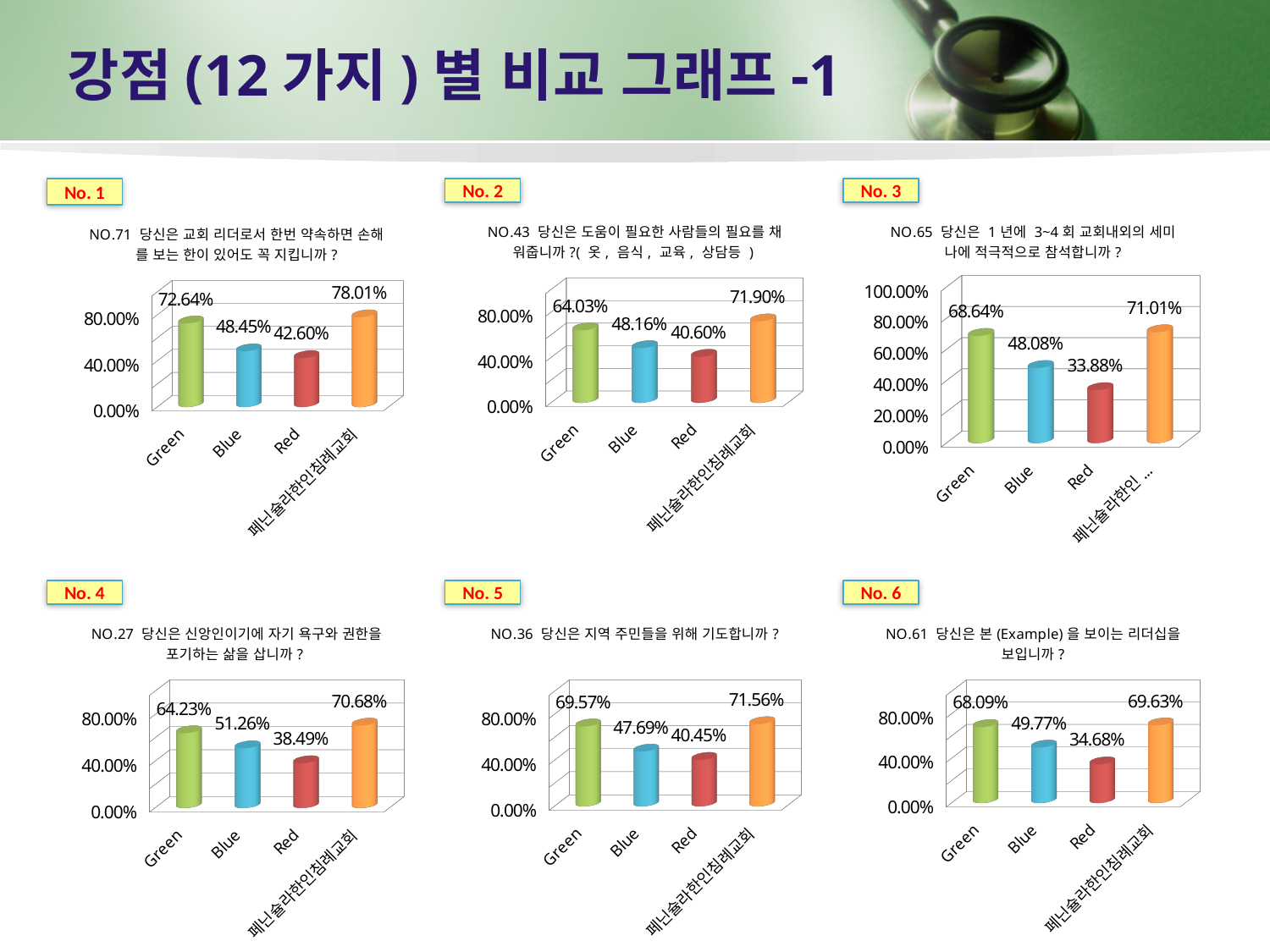
In the No. 3 chart, what is the value for 페닌술라한인침례교회? 71.01% In the No. 2 chart, which category has the highest value? 페닌슐라한인침례교회 In the No. 4 chart, what is the value for Blue? 51.26% In the No. 6 chart, is the value for Red greater or less than 40.00%? less In the No. 3 chart, which category has the lowest value? Red What kind of chart is the No. 6 chart? bar chart In the No. 5 chart, which is larger, the value for Green or the value for Blue? Green In the No. 1 chart, what is the value for Green? 72.64% In the No. 4 chart, what is the difference between the values for Blue and Red? 12.77% How many categories are shown on the x axis of the No. 5 chart? 4 In the No. 2 chart, what is the value for Red? 40.60% In the No. 1 chart, what is the difference between the values for 페닌술라한인침례교회 and Green? 5.37%